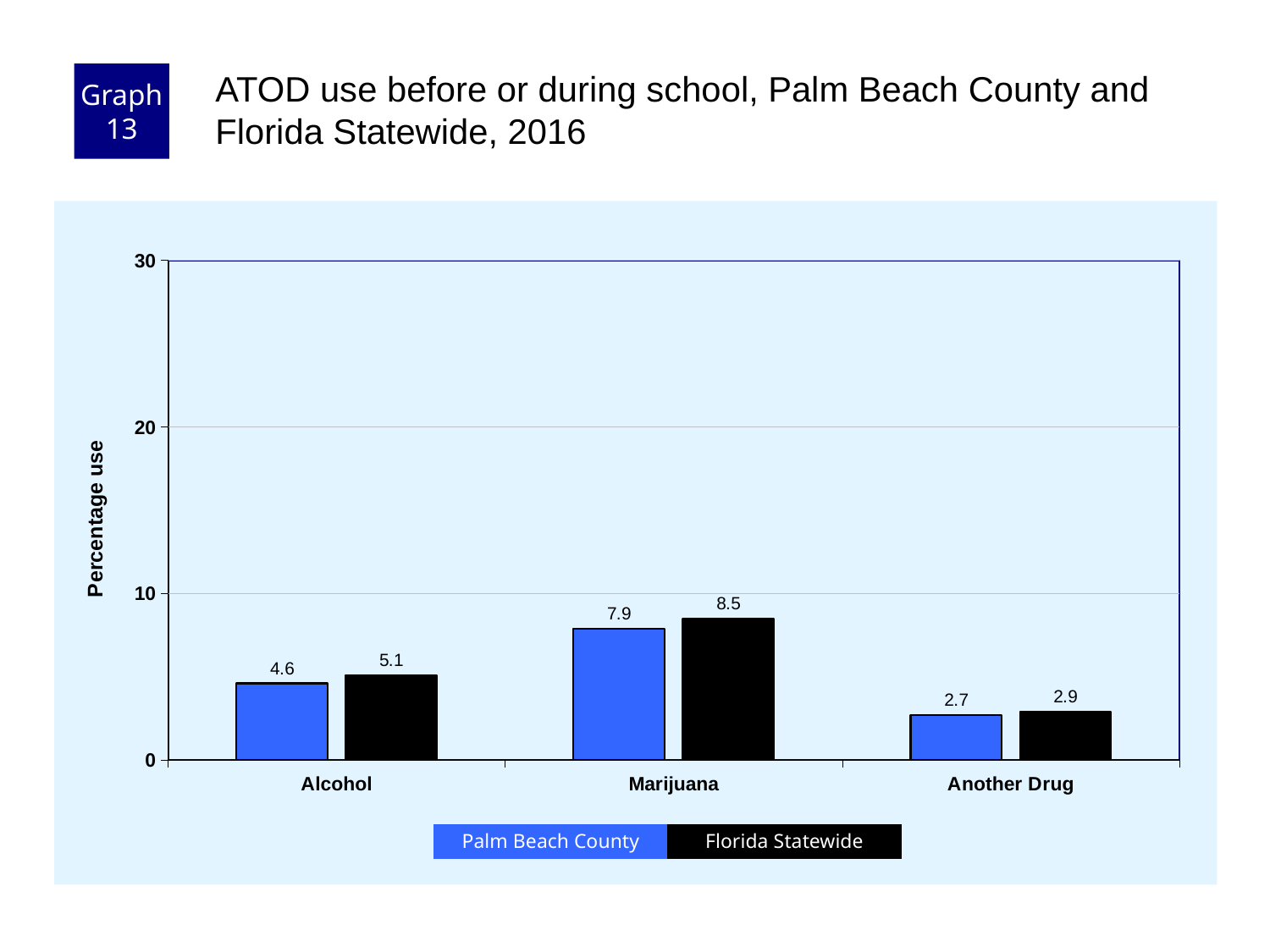
What kind of chart is shown on the slide? bar chart Is the Florida Statewide value for Marijuana greater or less than 10? less What is the Palm Beach County value for Another Drug? 2.7 What is the Florida Statewide value for Marijuana? 8.5 Which is larger for Another Drug: Palm Beach County or Florida Statewide? Florida Statewide What is the Palm Beach County value for Alcohol? 4.6 What is the difference between the Florida Statewide and Palm Beach County values for Marijuana? 0.6 How many categories are shown on the x axis? 3 Which category has the highest Florida Statewide value? Marijuana Which category has the lowest Palm Beach County value? Another Drug What is the difference between the Florida Statewide and Palm Beach County values for Alcohol? 0.5 How many series does the legend list? 2